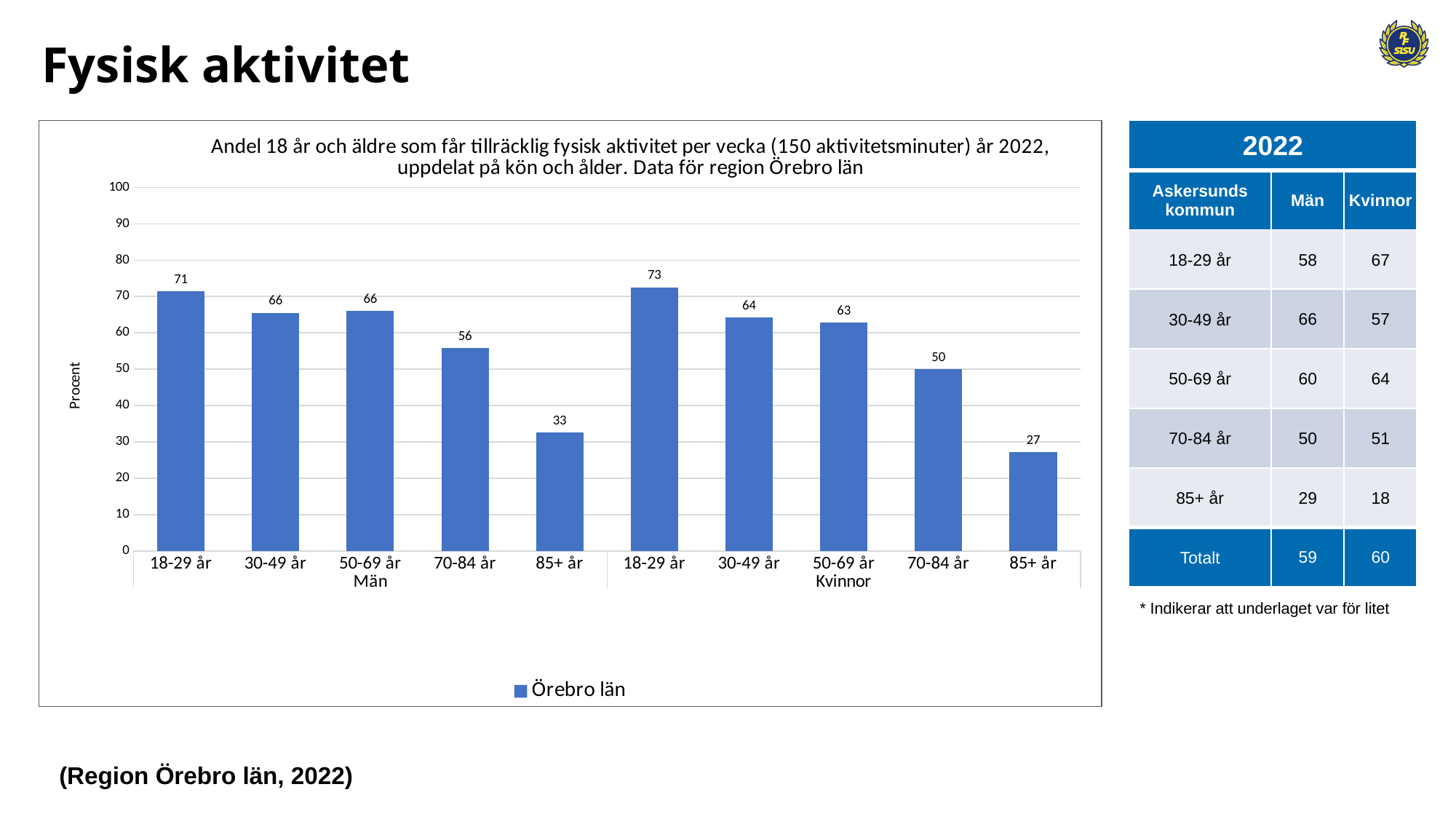
Which bar has the highest value in the chart? Kvinnor 18-29 år What is the label on the vertical axis of the chart? Procent Which is larger: the value for men aged 70-84 år or women aged 70-84 år? Men aged 70-84 år What kind of chart is shown on the slide? Bar chart How many bars are plotted in the chart? 10 Is the value for men aged 85+ år greater or less than 40? less What is the value for women aged 85+ år? 27 What is the difference between the values for men aged 18-29 år and men aged 85+ år? 38 What is the value for men aged 18-29 år? 71 Which bar has the lowest value in the chart? Kvinnor 85+ år What is the value for women aged 70-84 år? 50 How many series does the legend list? 1